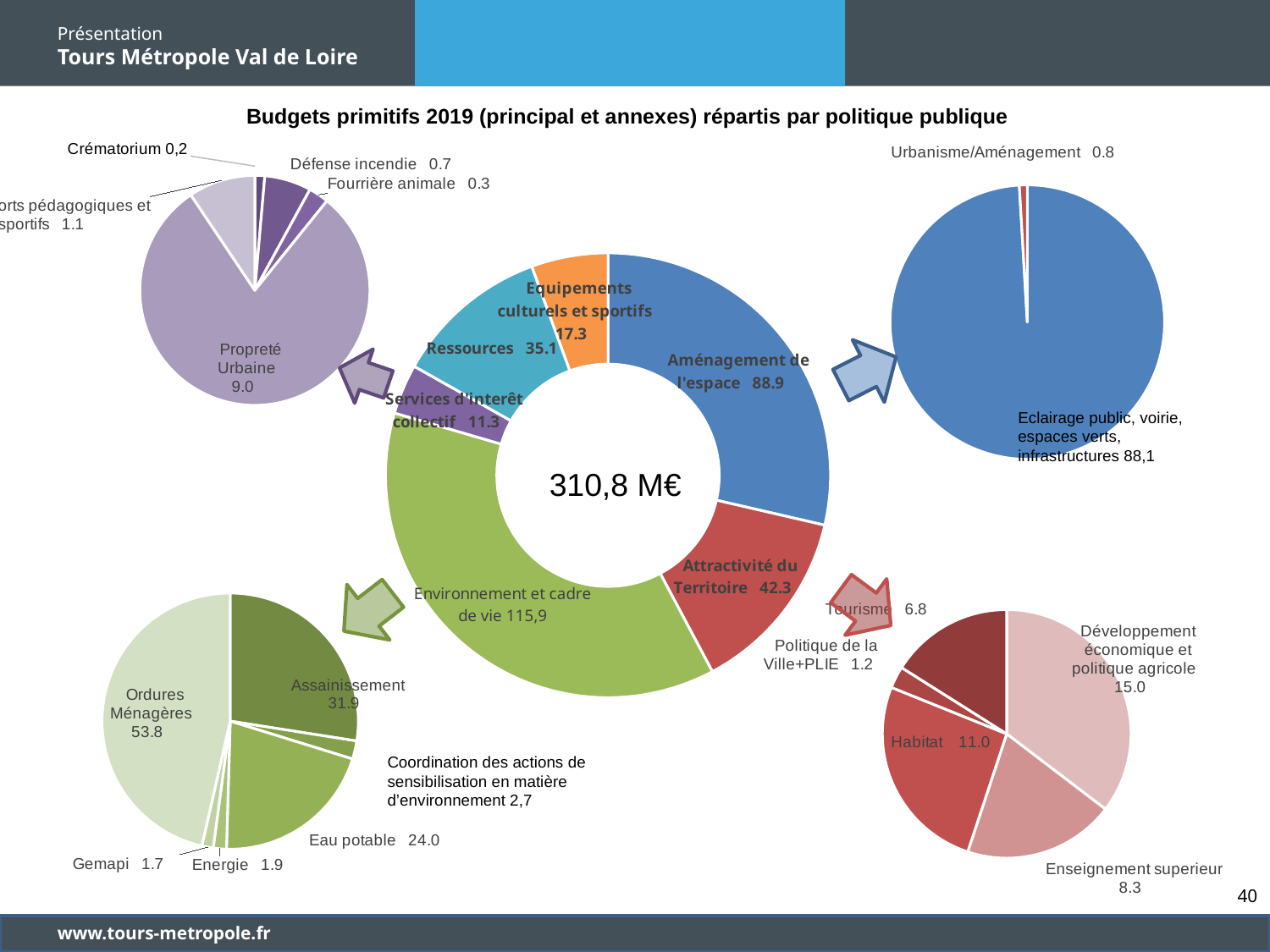
On the central donut chart, which category has the lowest value? Services d'interêt collectif On the bottom-right pie chart, what is the value for Habitat? 11.0 On the central donut chart, what is the difference between Ressources and Equipements culturels et sportifs? 17.8 On the central donut chart, what is the value for Environnement et cadre de vie? 115,9 On the bottom-left pie chart, what is the value for Ordures Ménagères? 53.8 What total is printed in the centre of the central donut chart? 310,8 M€ On the central donut chart, what is the value for Aménagement de l'espace? 88.9 On the top-left pie chart, what is the value for Propreté Urbaine? 9.0 On the top-right pie chart, what is the value for Urbanisme/Aménagement? 0.8 On the bottom-right pie chart, which category has the lowest value? Politique de la Ville+PLIE On the bottom-left pie chart, which is larger, Assainissement or Eau potable? Assainissement On the central donut chart, which category has the highest value? Environnement et cadre de vie